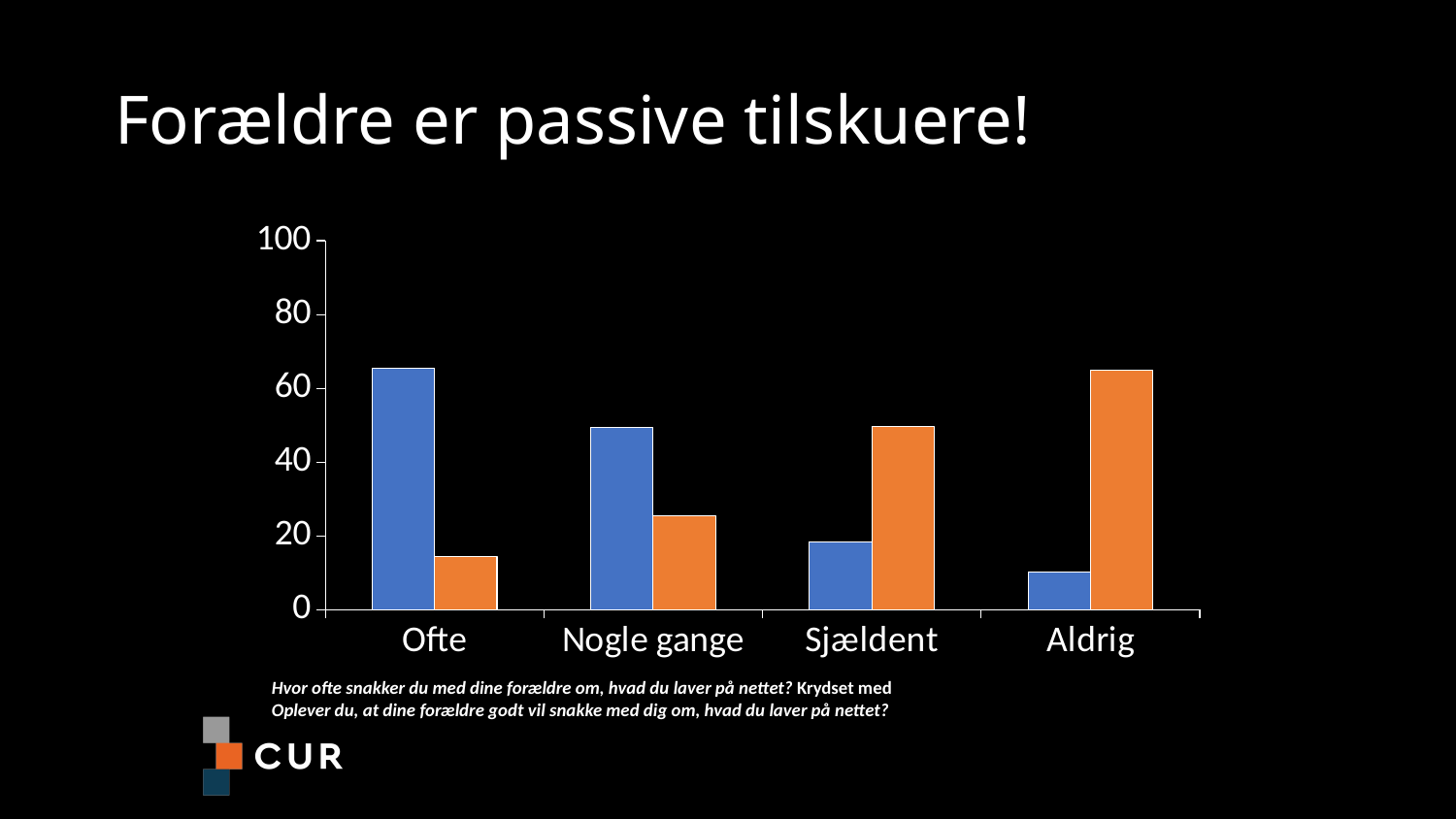
Is the orange bar for Aldrig greater or less than 60? greater Is the blue bar for Aldrig greater or less than 20? less Is the orange bar for Sjældent greater or less than 40? greater For which category is the blue bar lowest? Aldrig For Ofte, which bar is larger, the blue or the orange? blue Do the blue bars rise or fall from Ofte to Aldrig? fall For which category is the orange bar highest? Aldrig How many categories are shown on the x axis? 4 What kind of chart is shown on the slide? bar chart For which category is the blue bar highest? Ofte